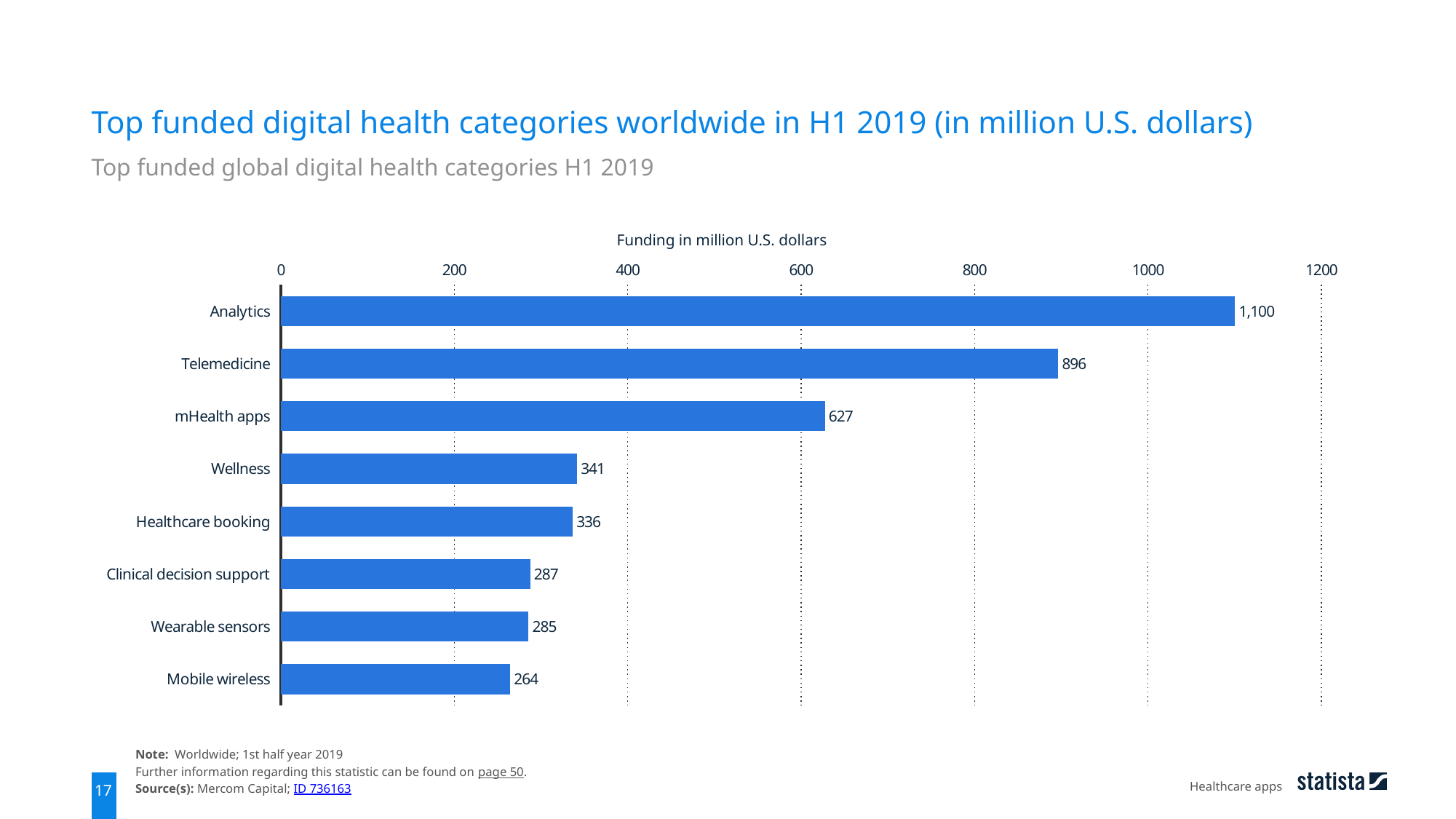
What is the difference in funding between mHealth apps and Wellness? 286 What is the label of the value axis? Funding in million U.S. dollars Which received more funding, Healthcare booking or Clinical decision support? Healthcare booking Which category received the highest funding? Analytics What is the difference in funding between Analytics and Telemedicine? 204 What is the funding value for Wearable sensors? 285 What kind of chart is shown on the slide? Bar chart What is the funding value for Telemedicine? 896 Is the value for mHealth apps greater or less than 600? greater Which category received the lowest funding? Mobile wireless Is the value for Mobile wireless greater or less than 400? less How many categories are shown in the chart? 8